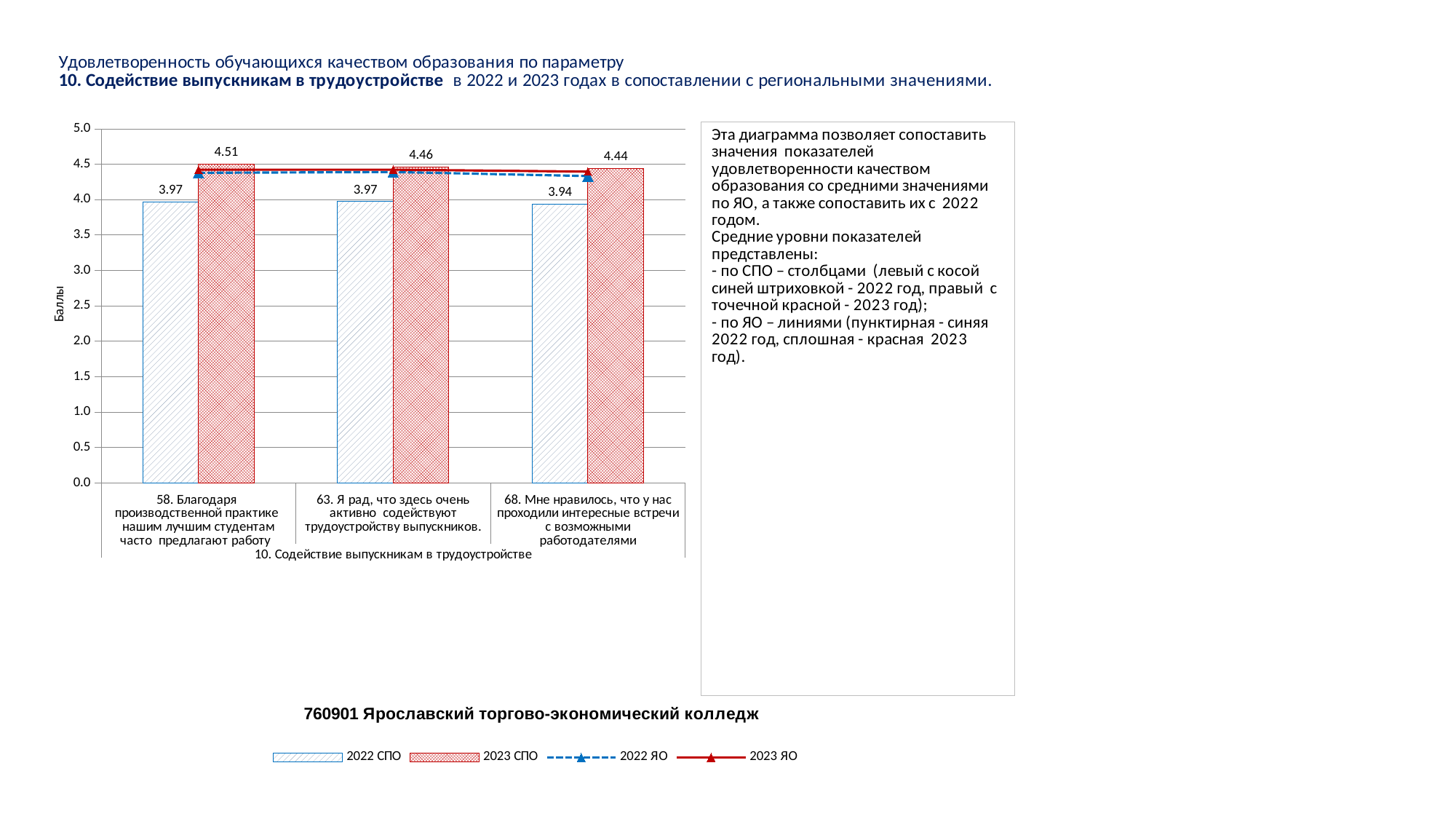
What is the label of the y axis? Баллы What kind of chart is this? Combined bar and line chart What is the 2022 СПО value for category 68 (Мне нравилось, что у нас проходили интересные встречи с возможными работодателями)? 3.94 Which category has the highest 2023 СПО value? 58. Благодаря производственной практике нашим лучшим студентам часто предлагают работу Is the 2022 ЯО value for category 58 greater or less than 4.0? greater How many categories are shown on the x axis? 3 What is the difference between the 2023 СПО and 2022 СПО values for category 58? 0.54 How many series does the legend list? 4 For category 68, which is larger: the 2022 СПО value or the 2023 СПО value? 2023 СПО What is the 2023 СПО value for category 58 (Благодаря производственной практике нашим лучшим студентам часто предлагают работу)? 4.51 What is the 2023 СПО value for category 63 (Я рад, что здесь очень активно содействуют трудоустройству выпускников)? 4.46 Which category has the lowest 2022 СПО value? 68. Мне нравилось, что у нас проходили интересные встречи с возможными работодателями